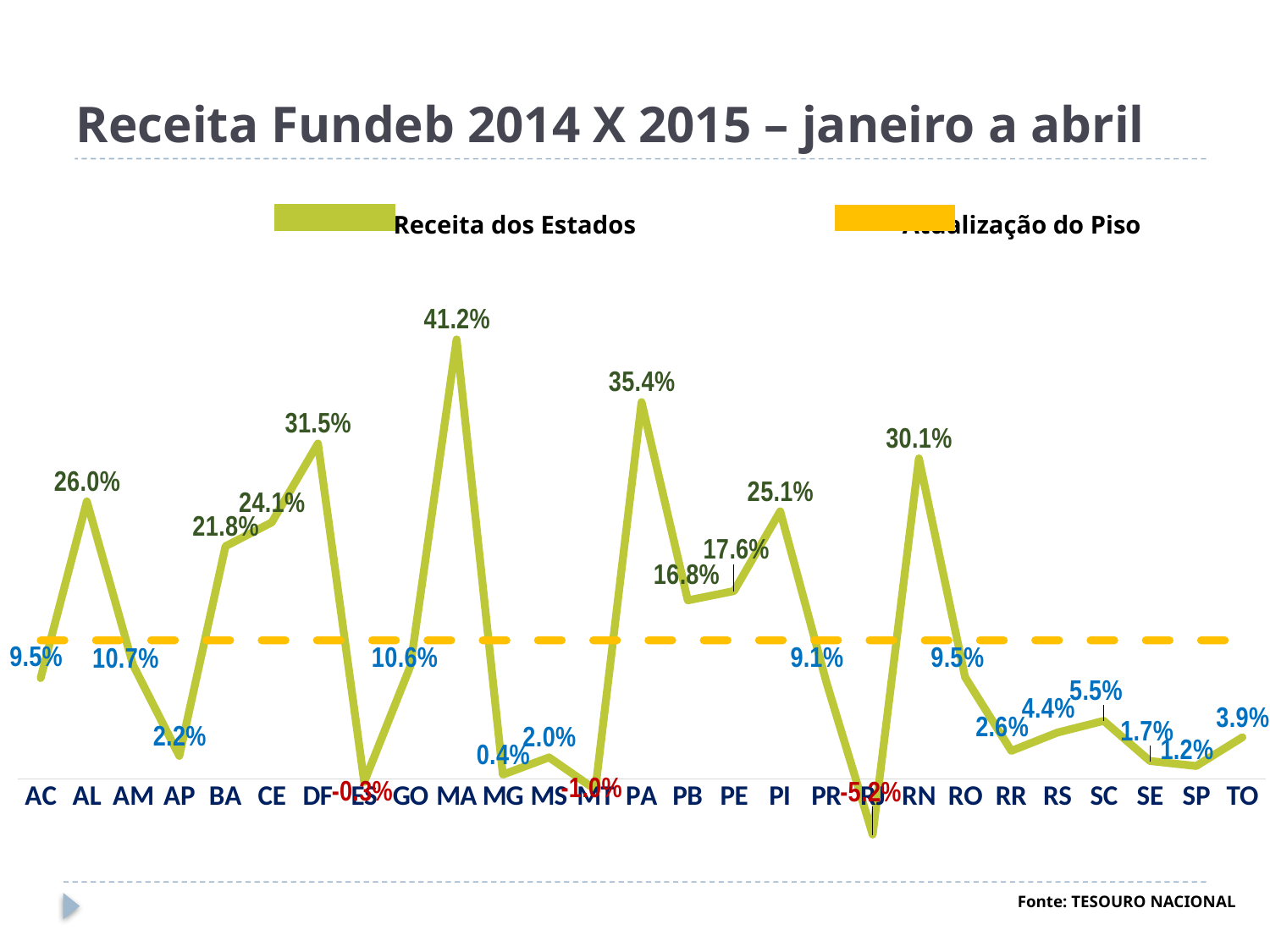
What is the value for PI? 25.1% What is the difference between the values for DF and CE? 7.4 percentage points What is the value for SP? 1.2% What kind of chart is shown on the slide? Line chart What is the value for DF? 31.5% What is the value for MA in the Receita dos Estados series? 41.2% Which state has the highest value in the chart? MA How many series does the legend list? 2 What is the difference between the values for MA and PA? 5.8 percentage points How many states are shown on the x axis? 27 Which has a larger value, AL or RN? RN Which has a larger value, PB or PE? PE